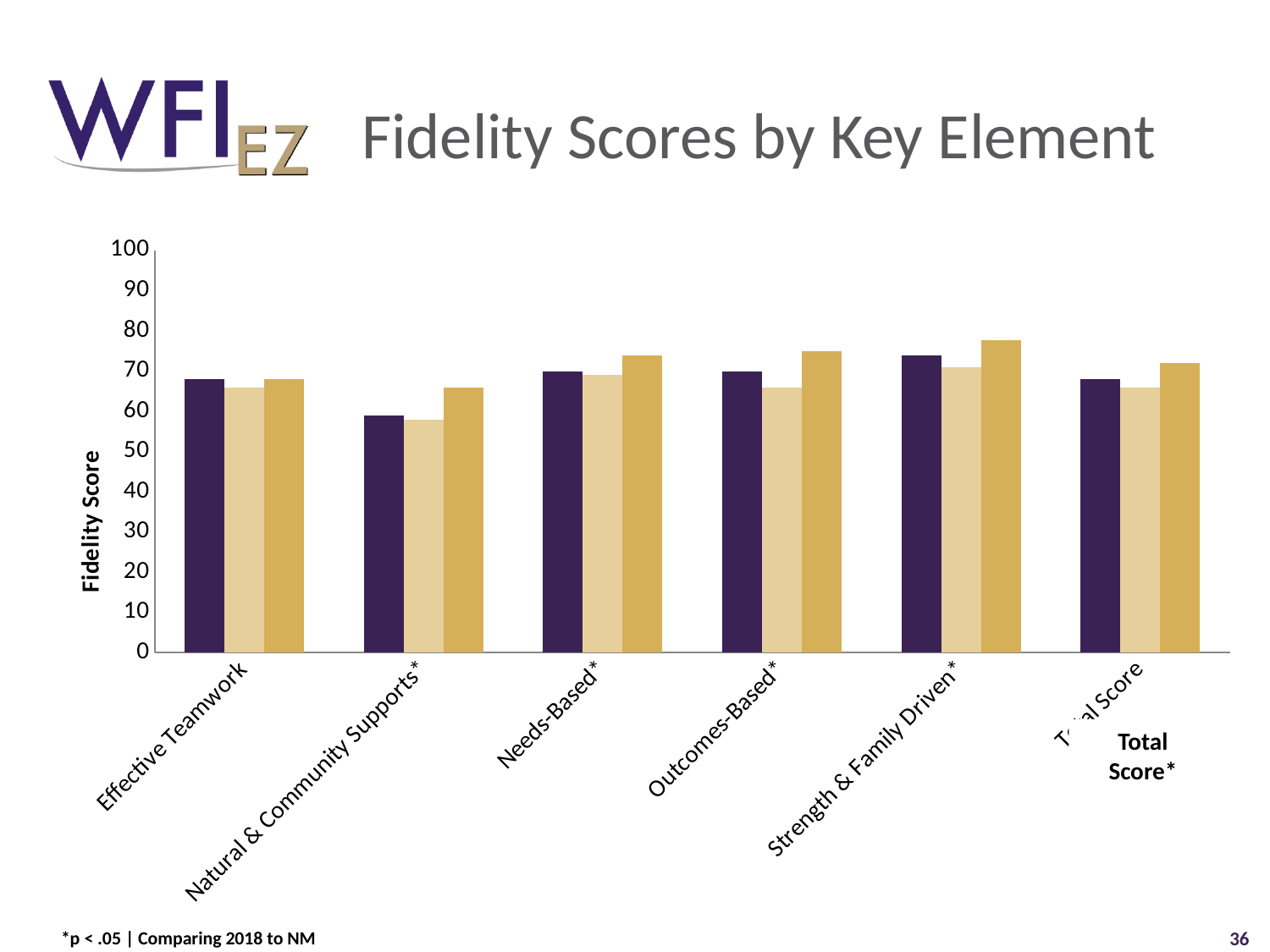
Is the dark purple bar for Effective Teamwork greater or less than 70? less What type of chart is shown on the slide? bar chart How many key element categories are shown along the x axis? 6 Which category has the lowest fidelity scores across all three bars? Natural & Community Supports* What is the title of the chart? Fidelity Scores by Key Element How many bars are plotted for each category? 3 What is the label on the vertical axis of the chart? Fidelity Score Is the gold bar for Strength & Family Driven* greater or less than 70? greater Is the light tan bar for Natural & Community Supports* greater or less than 60? less Which category has the tallest dark purple (leftmost) bar? Strength & Family Driven* Which category has the tallest gold (rightmost) bar? Strength & Family Driven* For Outcomes-Based*, which is larger: the gold bar or the light tan bar? the gold bar